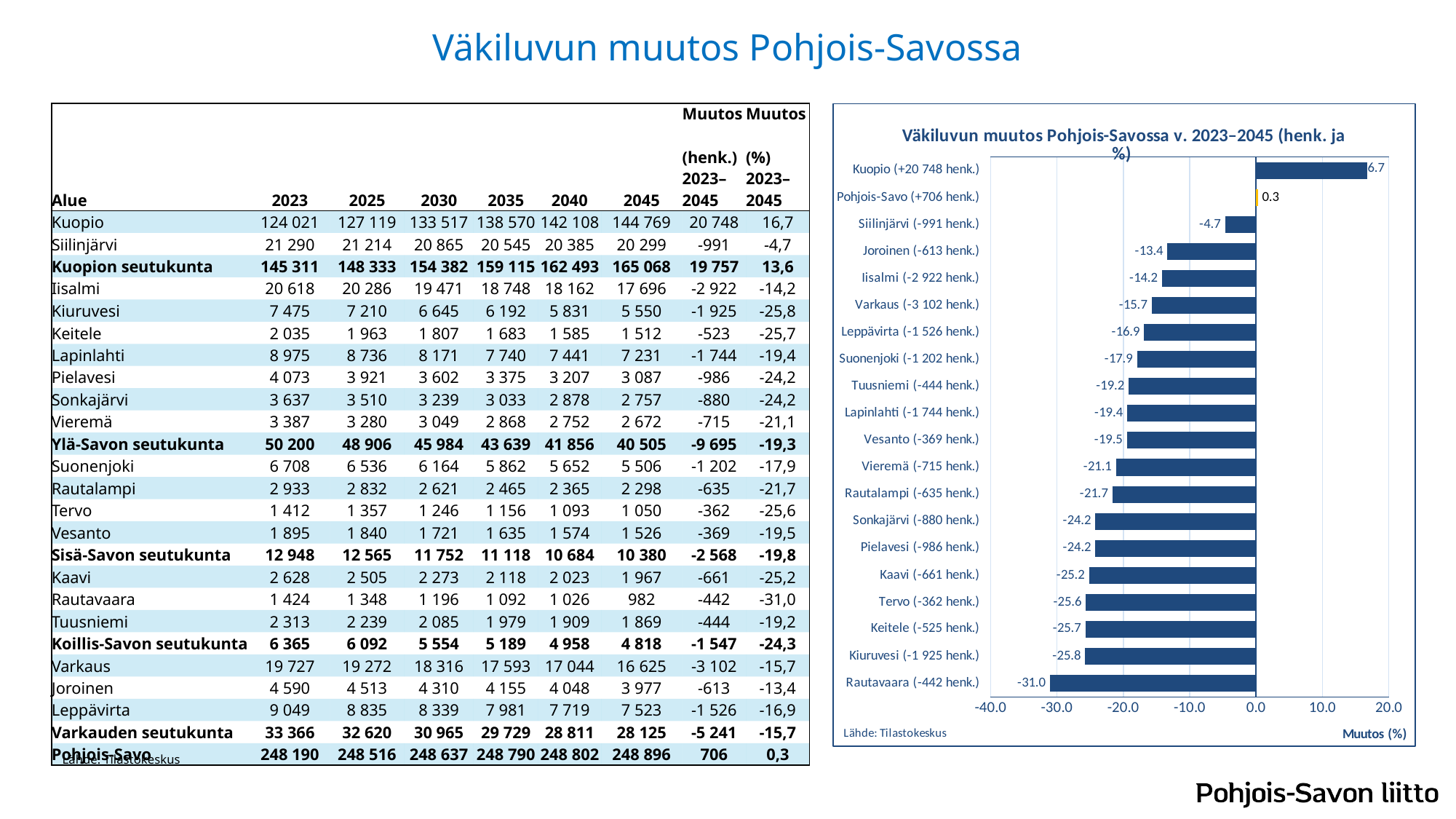
What is the x-axis label of the chart? Muutos (%) In the chart, what is the value for Pohjois-Savo? 0.3 In the chart, what is the difference between the values for Iisalmi and Varkaus? 1.5 Which category in the chart has the highest value? Kuopio In the chart, which has the larger value, Leppävirta or Kiuruvesi? Leppävirta How many categories are plotted in the chart? 20 In the chart, what is the value for Siilinjärvi? -4.7 In the chart, what is the value for Joroinen? -13.4 In the chart, what is the value for Rautavaara? -31.0 Is the value for Kuopio in the chart greater or less than 10.0? greater What kind of chart is shown on the right side of the slide? bar chart Which category in the chart has the lowest value? Rautavaara